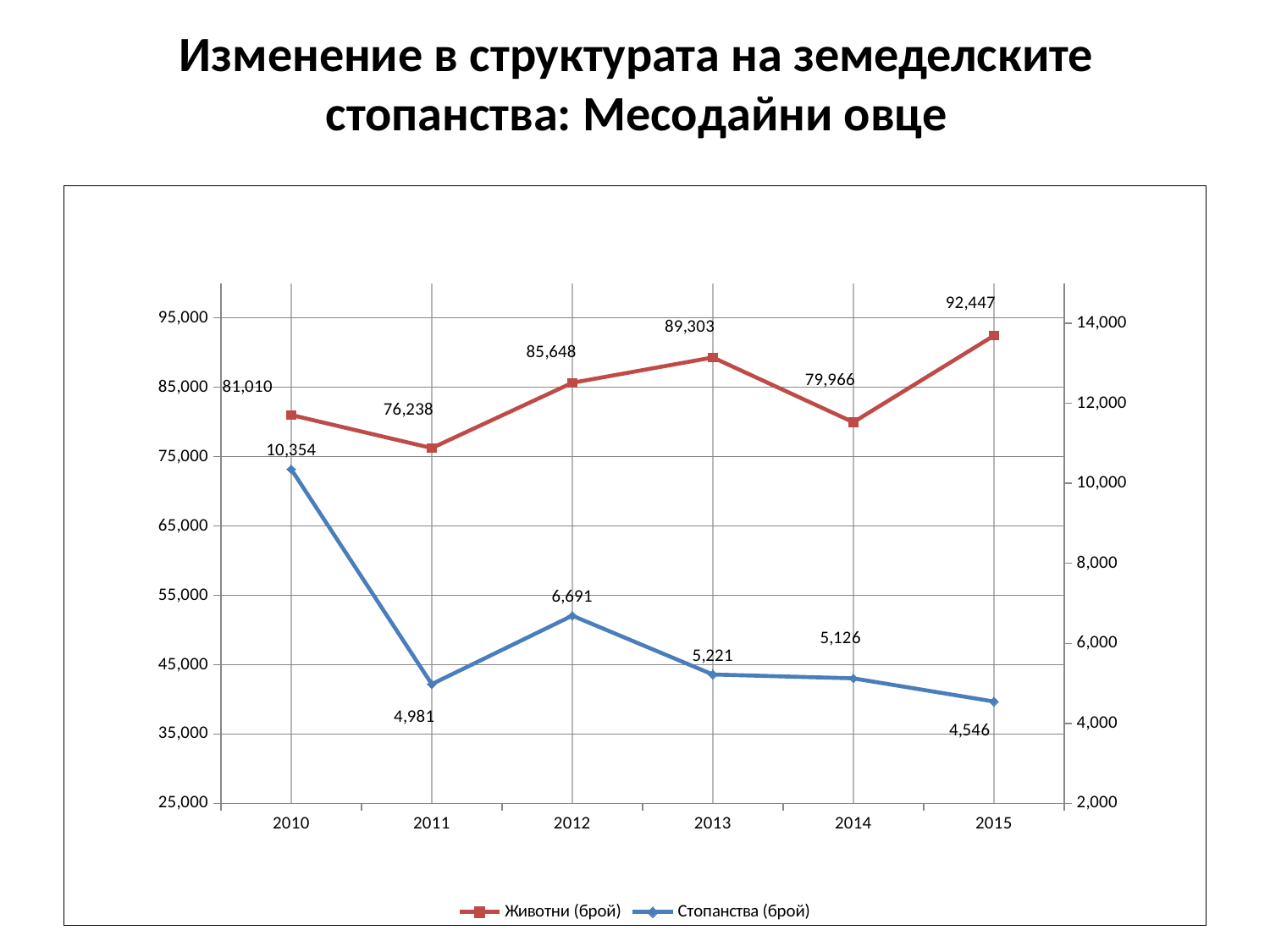
In which year is Стопанства (брой) lowest? 2015 What is the value of Стопанства (брой) in 2010? 10,354 In which year is Животни (брой) highest? 2015 What kind of chart is shown on the slide? Line chart What is the value of Животни (брой) in 2011? 76,238 What is the difference between Животни (брой) in 2015 and in 2014? 12,481 How many series does the legend list? 2 What is the value of Животни (брой) in 2015? 92,447 Does Стопанства (брой) rise or fall from 2010 to 2011? Fall What is the value of Стопанства (брой) in 2013? 5,221 Which is larger: Стопанства (брой) in 2012 or in 2014? 2012 How many years are shown on the x axis? 6